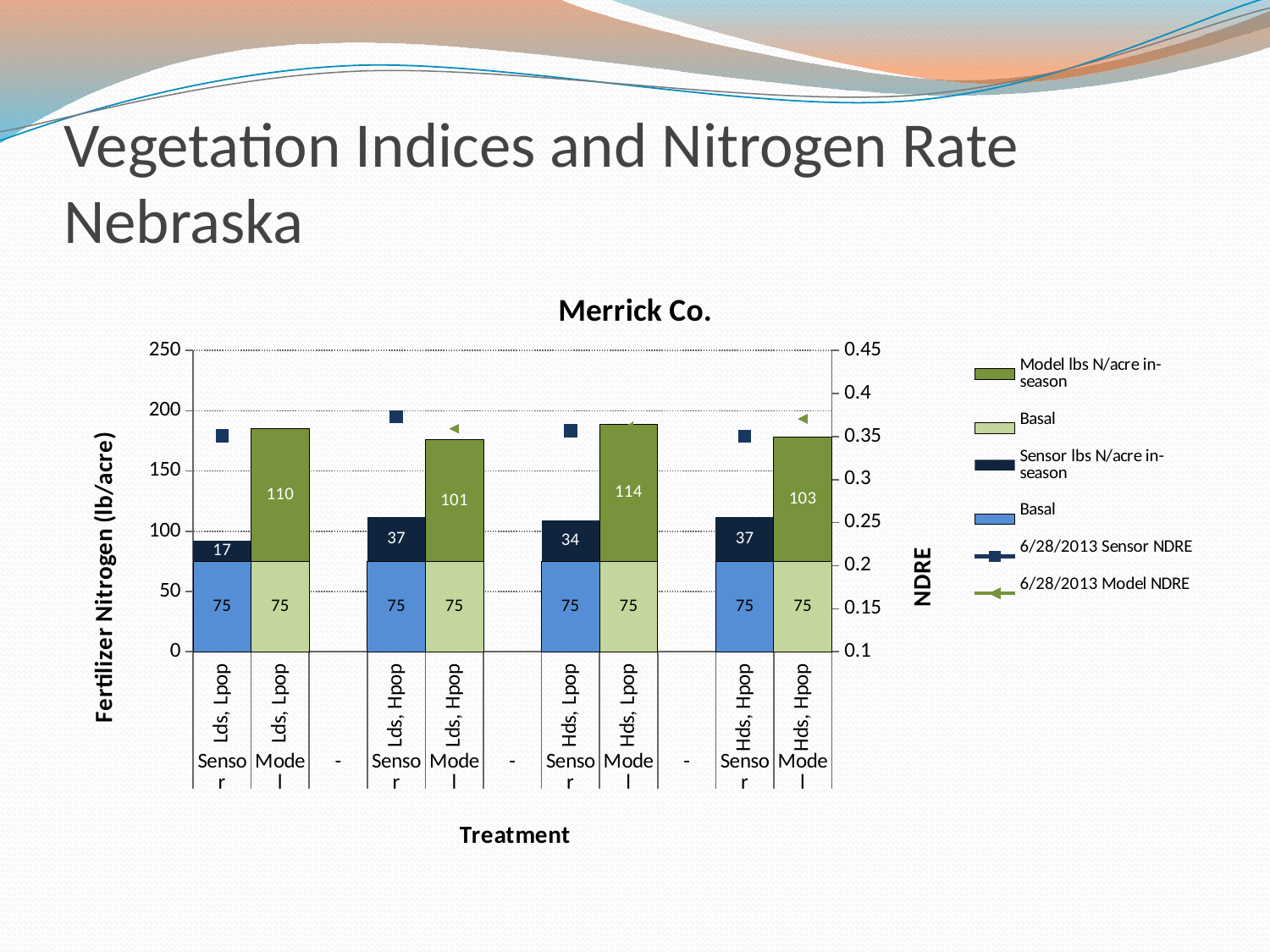
Is the 6/28/2013 Sensor NDRE value for Lds, Hpop greater or less than 0.35? greater What is the Model lbs N/acre in-season value for the Hds, Lpop treatment? 114 What is the total height of the Lds, Hpop Sensor stacked bar (Basal plus Sensor in-season)? 112 How many entries does the legend list? 6 What is the total height of the Lds, Lpop Model stacked bar (Basal plus Model in-season)? 185 Which treatment has the highest Model lbs N/acre in-season value? Hds, Lpop What is the Model lbs N/acre in-season value for the Lds, Lpop treatment? 110 What is the chart title? Merrick Co. What is the Sensor lbs N/acre in-season value for the Lds, Lpop treatment? 17 What is the Basal value for the Hds, Hpop Sensor bar? 75 What is the difference between the Model in-season values for Hds, Lpop and Lds, Hpop? 13 Which treatment has the lowest Sensor lbs N/acre in-season value? Lds, Lpop